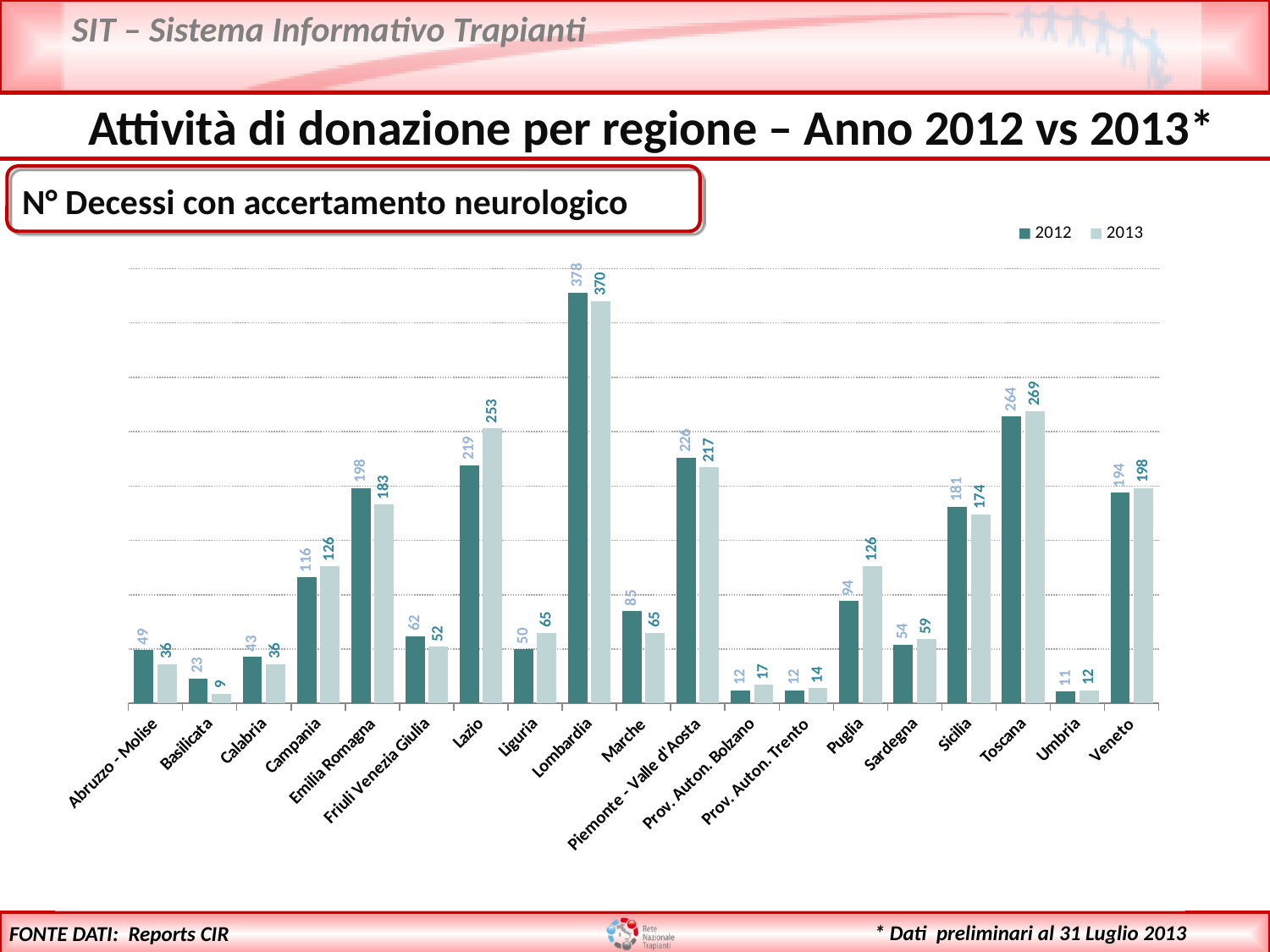
How many series does the legend list? 2 Which region has the highest 2012 value? Lombardia What is the 2013 value for Lazio? 253 Which region has the lowest 2013 value? Basilicata What kind of chart is shown on the slide? Bar chart Which is larger, the 2013 value for Toscana or the 2013 value for Piemonte - Valle d'Aosta? Toscana What is the difference between the 2012 and 2013 values for Lombardia? 8 What is the 2013 value for Puglia? 126 Which is larger for Marche, the 2012 value or the 2013 value? 2012 What is the difference between the 2013 and 2012 values for Lazio? 34 What is the 2012 value for Emilia Romagna? 198 How many regions are shown on the x axis? 19